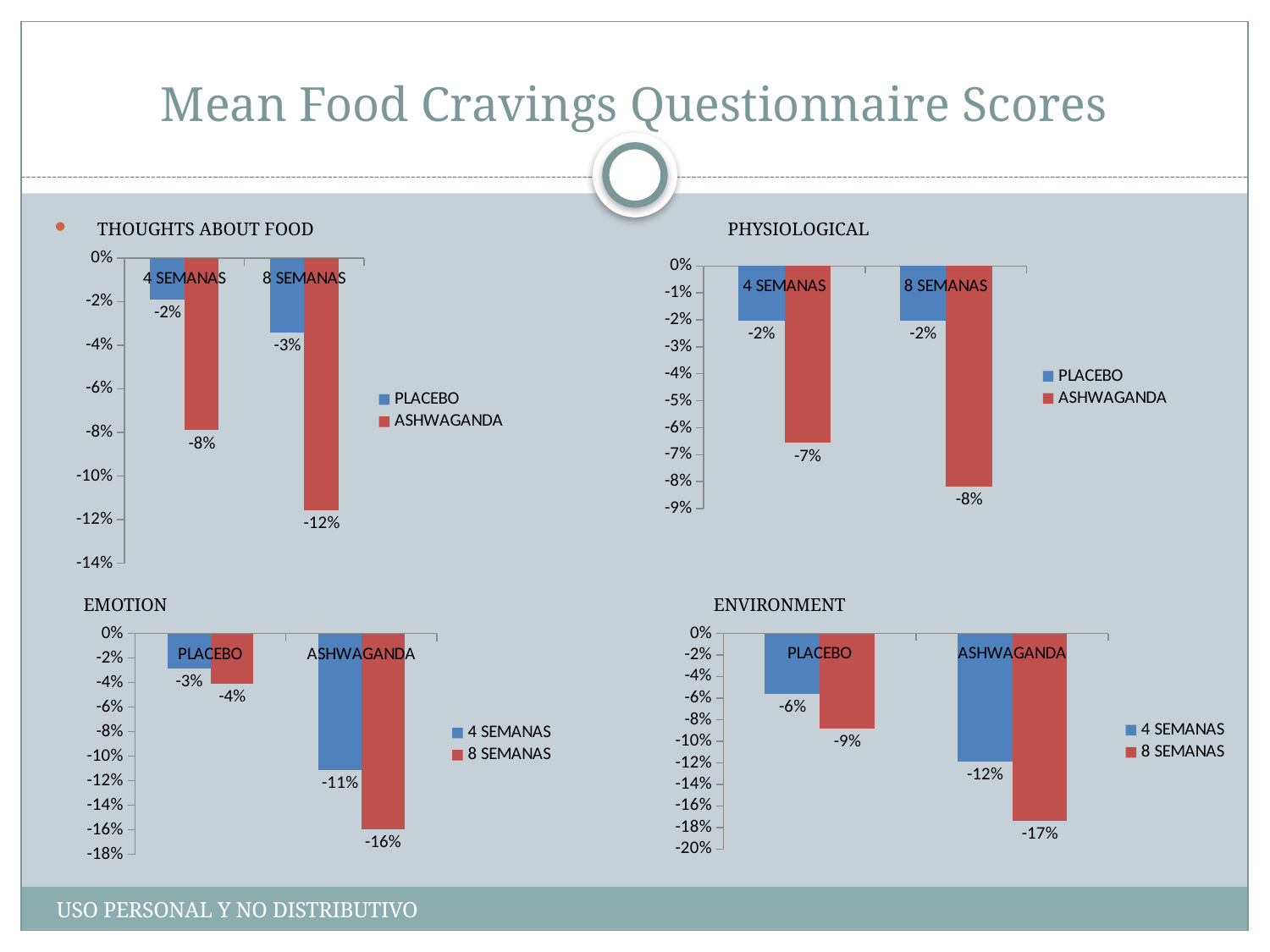
In the ENVIRONMENT chart, what is the value for PLACEBO at 8 SEMANAS? -9% What type of chart is the PHYSIOLOGICAL chart? Bar chart How many series does the legend of the EMOTION chart list? 2 In the PHYSIOLOGICAL chart, what is the difference between the PLACEBO and ASHWAGANDA values at 8 SEMANAS? 6% In the EMOTION chart, which bar shows the lowest value? ASHWAGANDA, 8 SEMANAS In the THOUGHTS ABOUT FOOD chart, which colour represents ASHWAGANDA? Red In the ENVIRONMENT chart, which is lower: PLACEBO at 4 SEMANAS or ASHWAGANDA at 4 SEMANAS? ASHWAGANDA at 4 SEMANAS In the PHYSIOLOGICAL chart, what is the value for ASHWAGANDA at 4 SEMANAS? -7% In the THOUGHTS ABOUT FOOD chart, what is the value for PLACEBO at 4 SEMANAS? -2% In the THOUGHTS ABOUT FOOD chart, what is the value for ASHWAGANDA at 8 SEMANAS? -12% In the ENVIRONMENT chart, what is the difference between the 4 SEMANAS and 8 SEMANAS values for ASHWAGANDA? 5% In the EMOTION chart, what is the value for ASHWAGANDA at 8 SEMANAS? -16%